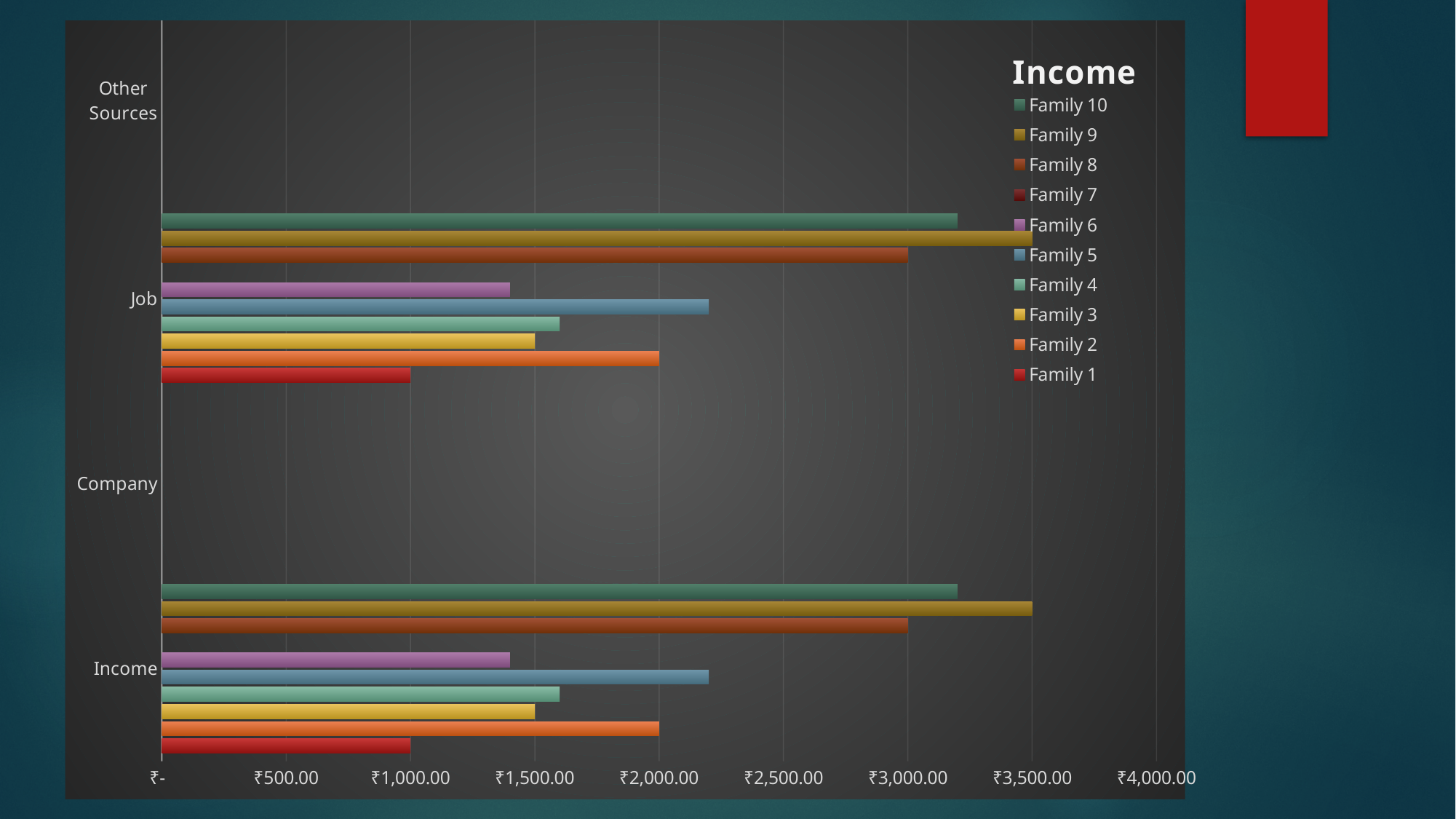
What is the value for Family 9 in the Income category? ₹3,500.00 What is the value for Family 2 in the Income category? ₹2,000.00 What is the title of the chart? Income What is the value for Family 1 in the Job category? ₹1,000.00 Which is larger in the Job category, Family 5 or Family 6? Family 5 Is the value for Family 10 in the Income category greater or less than ₹3,000.00? greater Which family has the shortest visible bar in the Income category? Family 1 How many series does the legend list? 10 What is the difference between Family 8 and Family 3 in the Job category? ₹1,500.00 Which family has the longest bar in the Job category? Family 9 How many categories are shown on the vertical axis? 4 What kind of chart is shown on the slide? bar chart